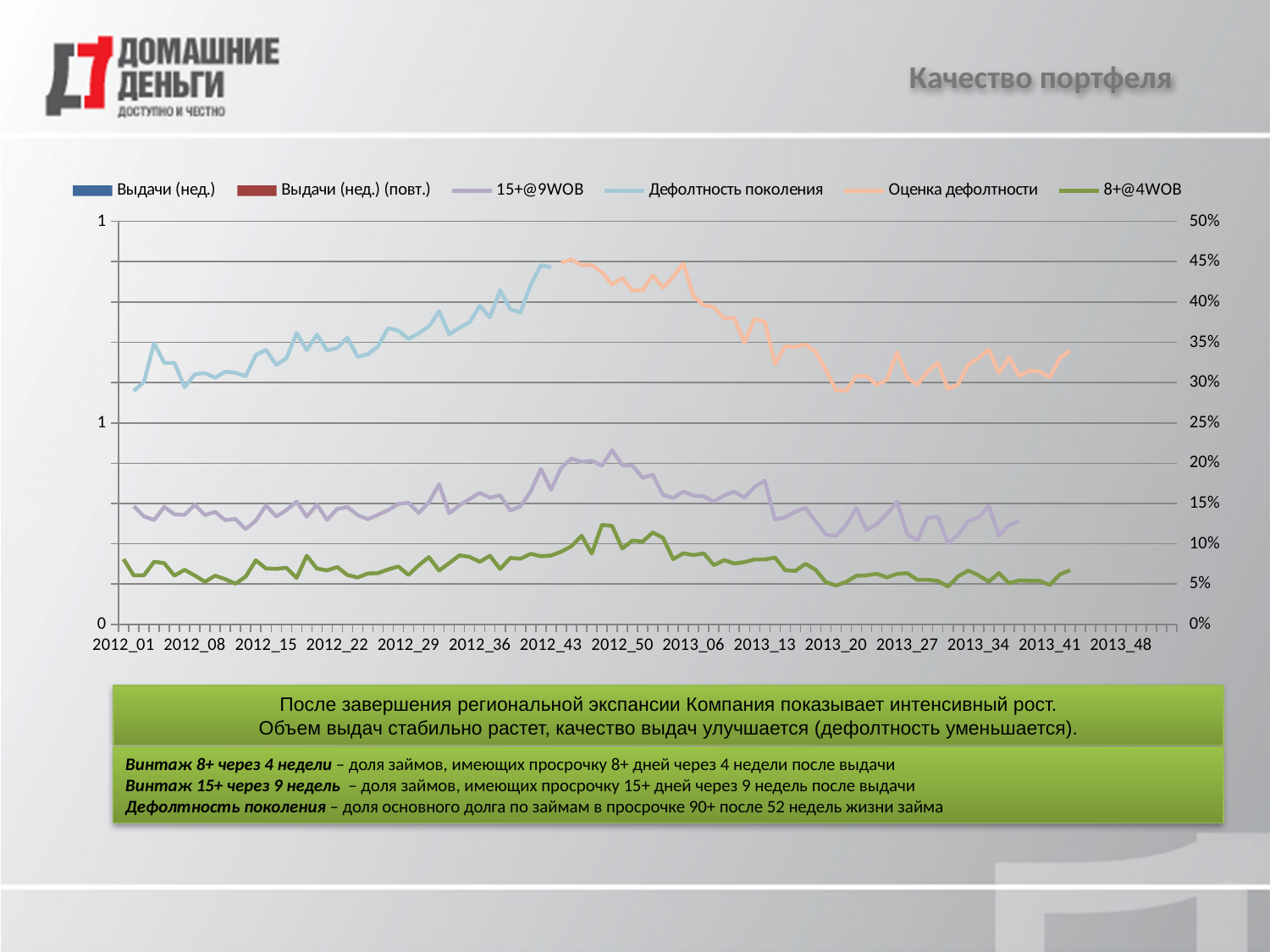
What is the highest value shown on the right-hand percentage axis? 50% At 2012_43, which series is higher: Дефолтность поколения or 8+@4WOB? Дефолтность поколения What is the title of the slide containing the chart? Качество портфеля What kind of chart is shown on the slide? line chart Does the 8+@4WOB line rise or fall from 2012_50 to 2013_34? fall Which plotted series has the lowest values across the whole period? 8+@4WOB Is the value of 15+@9WOB at 2012_50 greater or less than 15%? greater How many series does the chart legend list? 6 Is the value of 8+@4WOB at 2013_34 greater or less than 10%? less Does the Оценка дефолтности line rise or fall from 2012_43 to 2013_41? fall Is the value of Дефолтность поколения at 2012_43 greater or less than 40%? greater